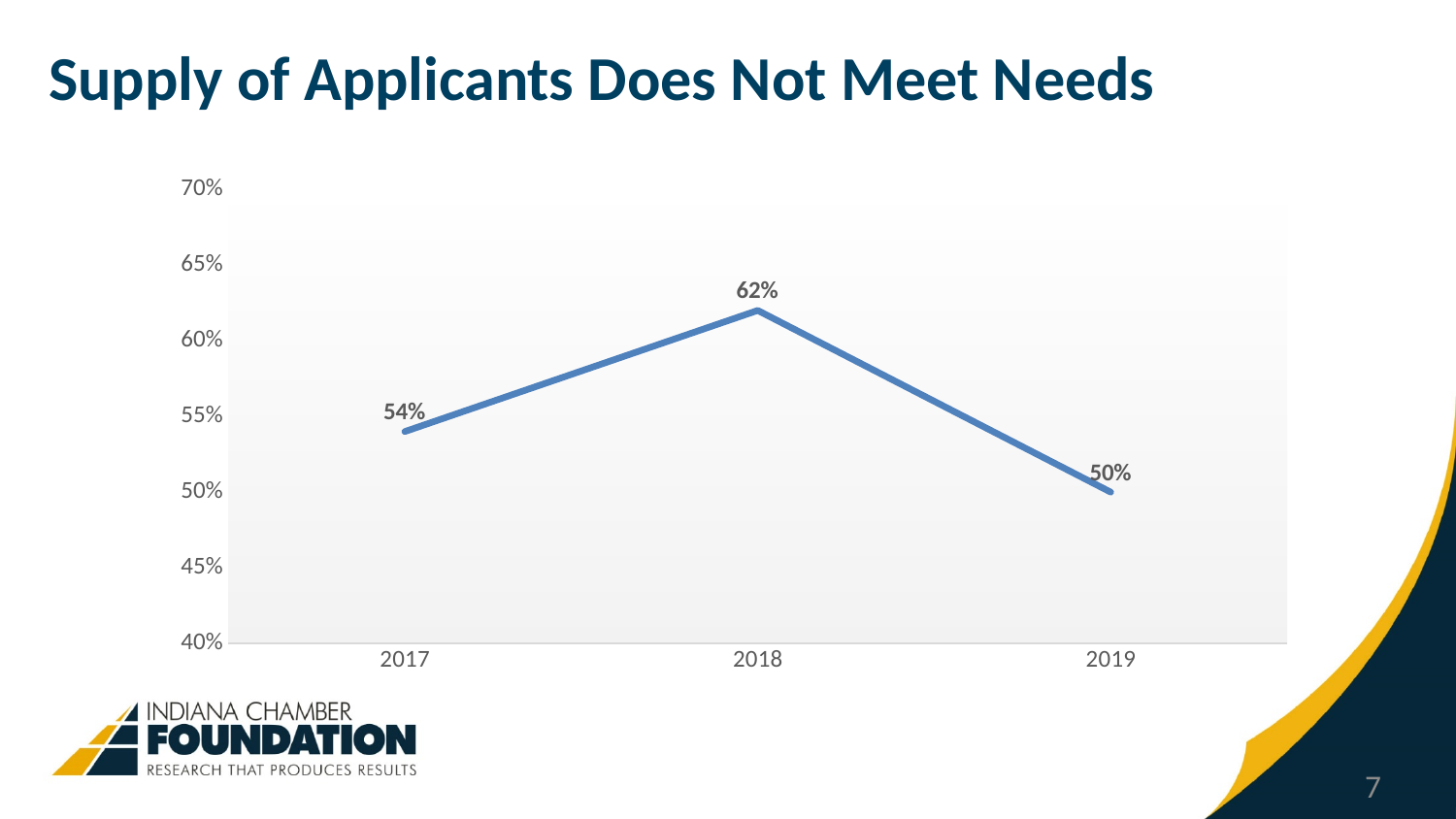
Which year has the lowest value? 2019 Which year has the highest value? 2018 What is the value for 2017? 54% What is the difference between the values for 2018 and 2019? 12% Does the value rise or fall from 2018 to 2019? fall What is the value for 2019? 50% Which is larger, the value for 2017 or the value for 2019? 2017 What is the difference between the values for 2018 and 2017? 8% How many years are plotted on the chart? 3 What is the value for 2018? 62% Is the value for 2018 greater or less than 60%? greater What kind of chart is shown on the slide? line chart